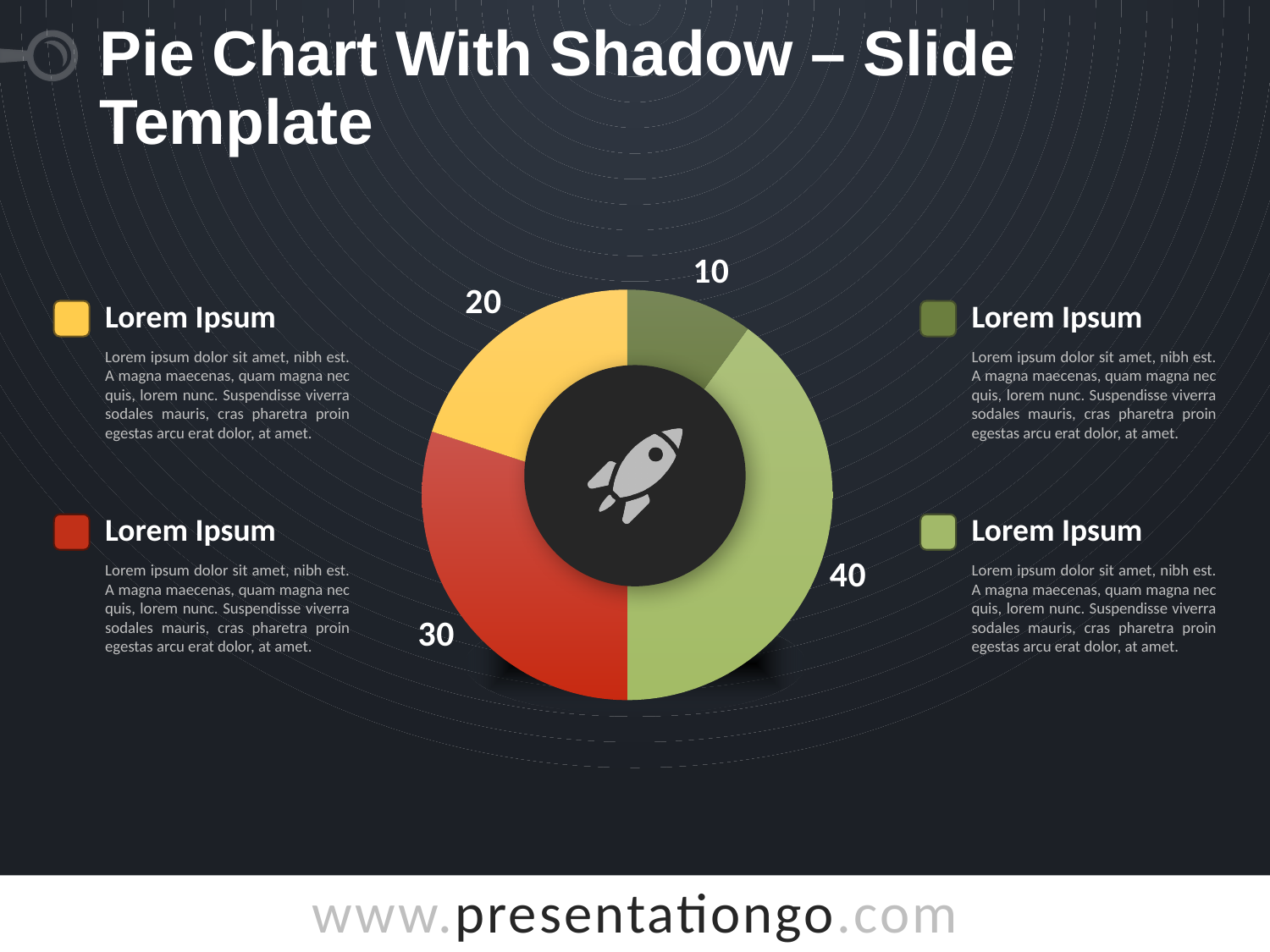
What share of the pie chart does the light green slice represent? 40% How many slices does the pie chart have? 4 What type of chart is shown on the slide? Pie chart Which is larger, the yellow slice or the red slice? The red slice What is the value of the yellow slice of the pie chart? 20 What is the value of the dark olive green slice of the pie chart? 10 What is the sum of all four slice values in the pie chart? 100 Which slice of the pie chart has the largest value? The light green slice (40) What is the value of the red slice of the pie chart? 30 What is the difference between the light green slice and the red slice? 10 Which slice of the pie chart has the smallest value? The dark olive green slice (10) What is the value of the light green slice of the pie chart? 40